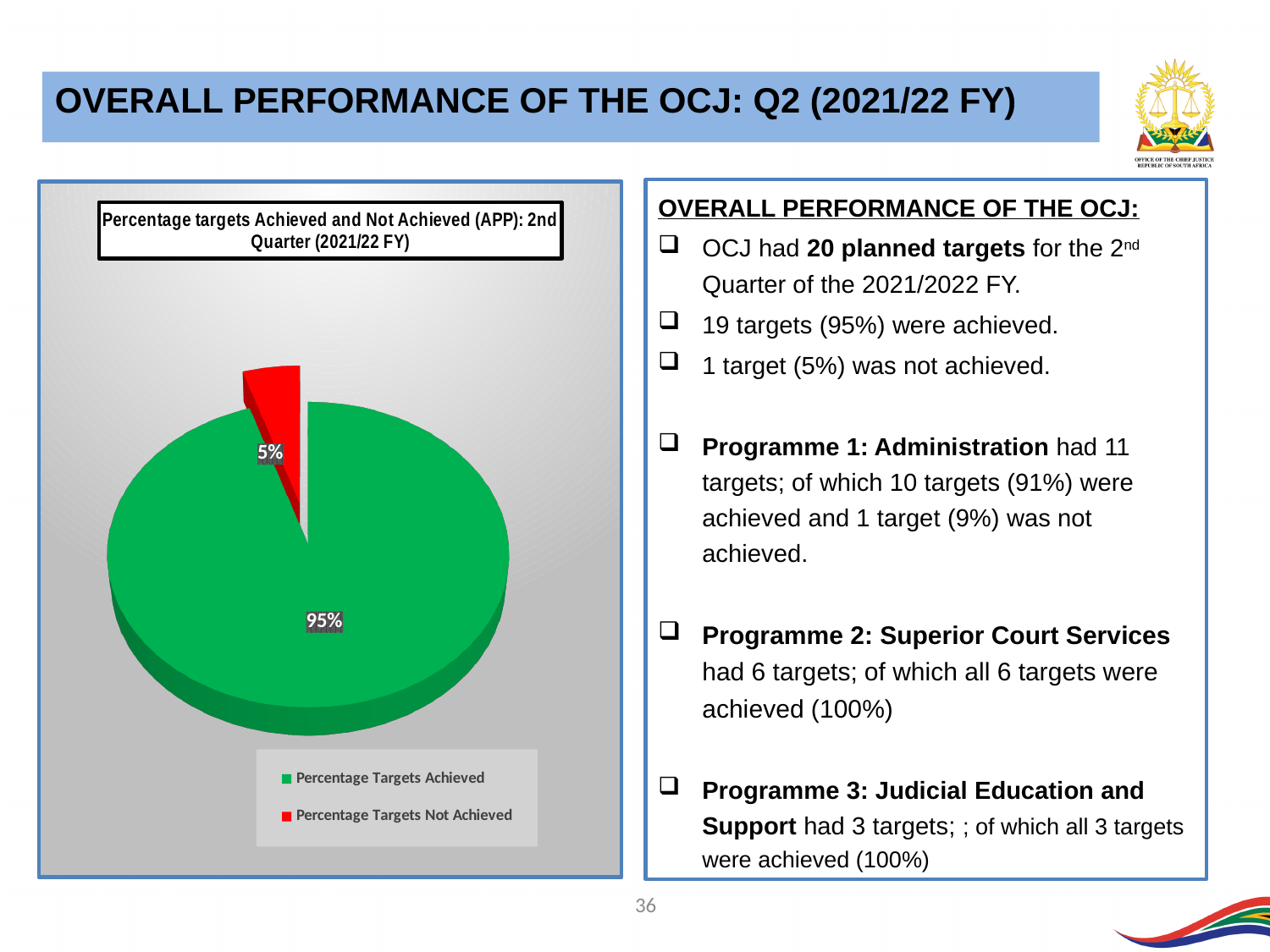
How many slices does the pie chart have? 2 Which slice of the pie chart is the largest? Percentage Targets Achieved What share of the pie does the Percentage Targets Not Achieved slice represent? 5% How many entries does the legend of the pie chart list? 2 Which slice of the pie chart is the smallest? Percentage Targets Not Achieved What is the value for Percentage Targets Achieved in the pie chart? 95% Which is larger: Percentage Targets Achieved or Percentage Targets Not Achieved? Percentage Targets Achieved What colour is the Percentage Targets Not Achieved slice in the pie chart? Red What is the value for Percentage Targets Not Achieved in the pie chart? 5% What is the difference between the Percentage Targets Achieved and Percentage Targets Not Achieved slices? 90% What kind of chart is shown on the slide? Pie chart What is the title of the pie chart? Percentage targets Achieved and Not Achieved (APP): 2nd Quarter (2021/22 FY)